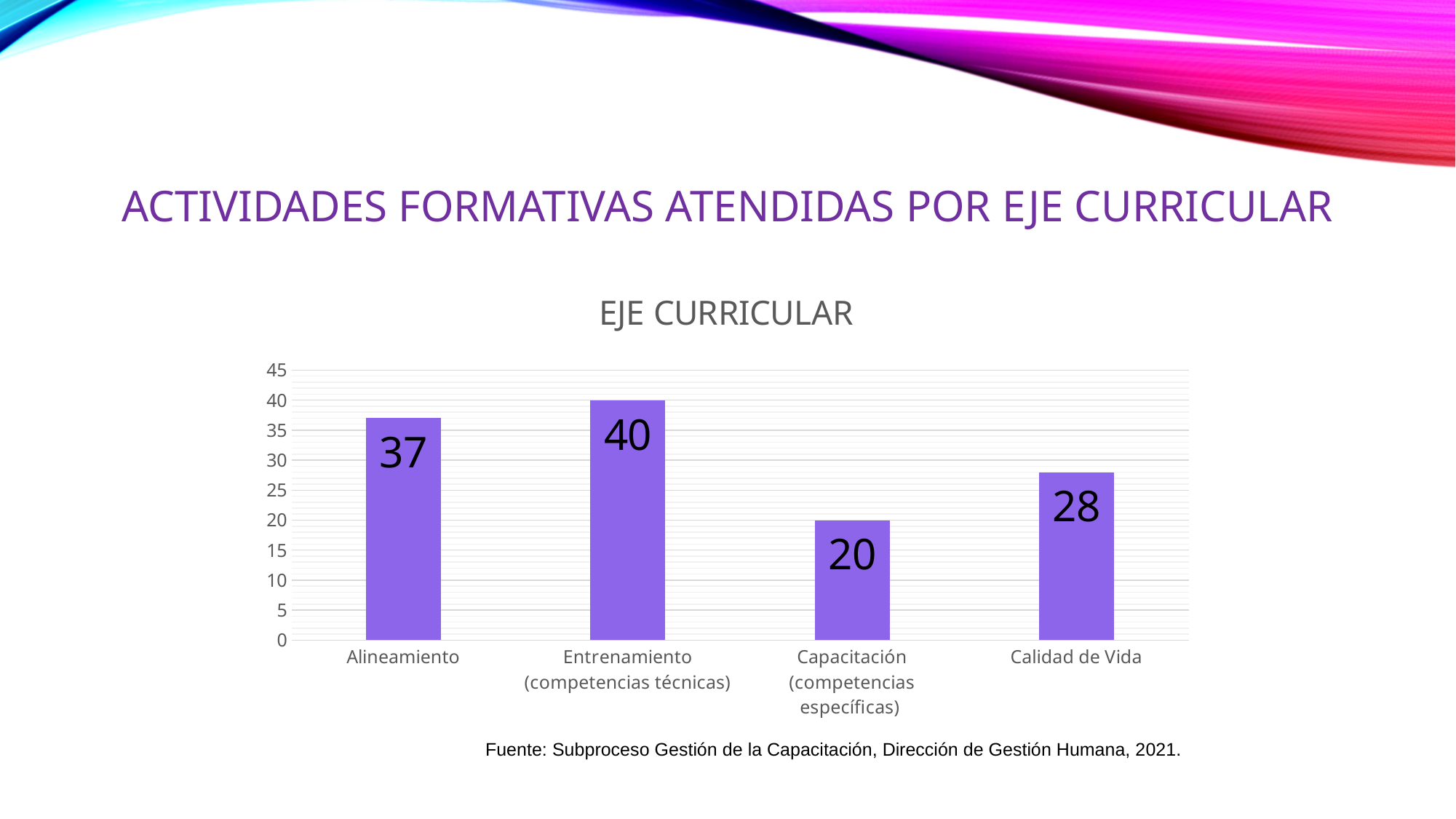
What is the difference between the values for Alineamiento and Calidad de Vida? 9 What is the value for Alineamiento? 37 What is the value for Capacitación (competencias específicas)? 20 What kind of chart is shown on the slide? Bar chart How many categories are shown on the x axis? 4 Which is larger, the value for Alineamiento or the value for Calidad de Vida? Alineamiento Which category has the highest value? Entrenamiento (competencias técnicas) What is the value for Entrenamiento (competencias técnicas)? 40 What is the title of the chart? EJE CURRICULAR Which category has the lowest value? Capacitación (competencias específicas) What is the difference between the values for Entrenamiento (competencias técnicas) and Capacitación (competencias específicas)? 20 What is the value for Calidad de Vida? 28